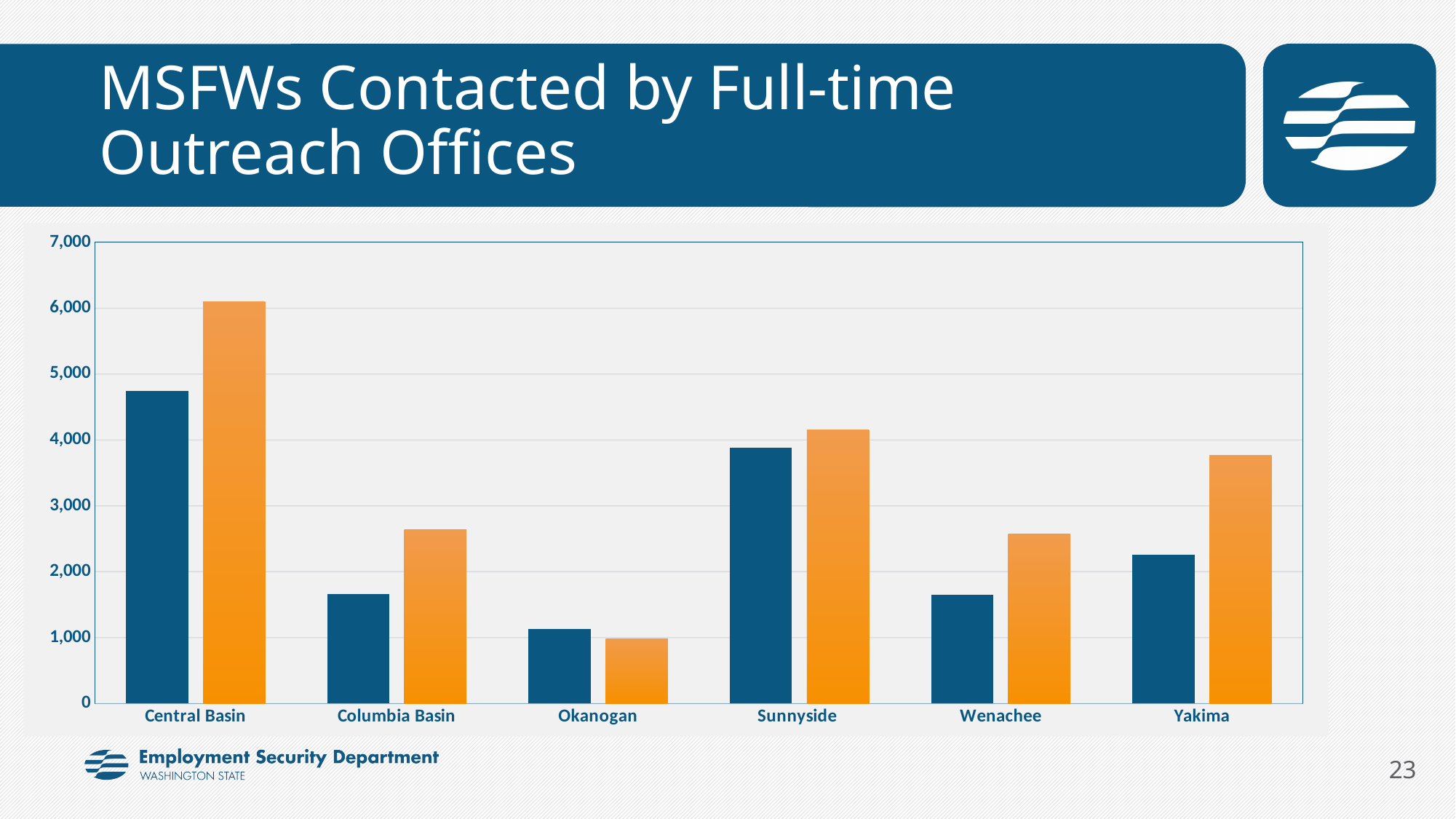
What is the title of the slide containing the chart? MSFWs Contacted by Full-time Outreach Offices Which office has the shortest blue bar? Okanogan Which office has the tallest orange bar? Central Basin What kind of chart is shown on the slide? bar chart Is the orange bar for Central Basin greater or less than 6,000? greater Is the blue bar for Okanogan greater or less than 2,000? less How many outreach offices (categories) are shown on the x axis? 6 For Okanogan, which bar is taller, the blue bar or the orange bar? the blue bar Which office has the tallest blue bar? Central Basin Is the orange bar for Sunnyside greater or less than 4,000? greater Which office has the shortest orange bar? Okanogan